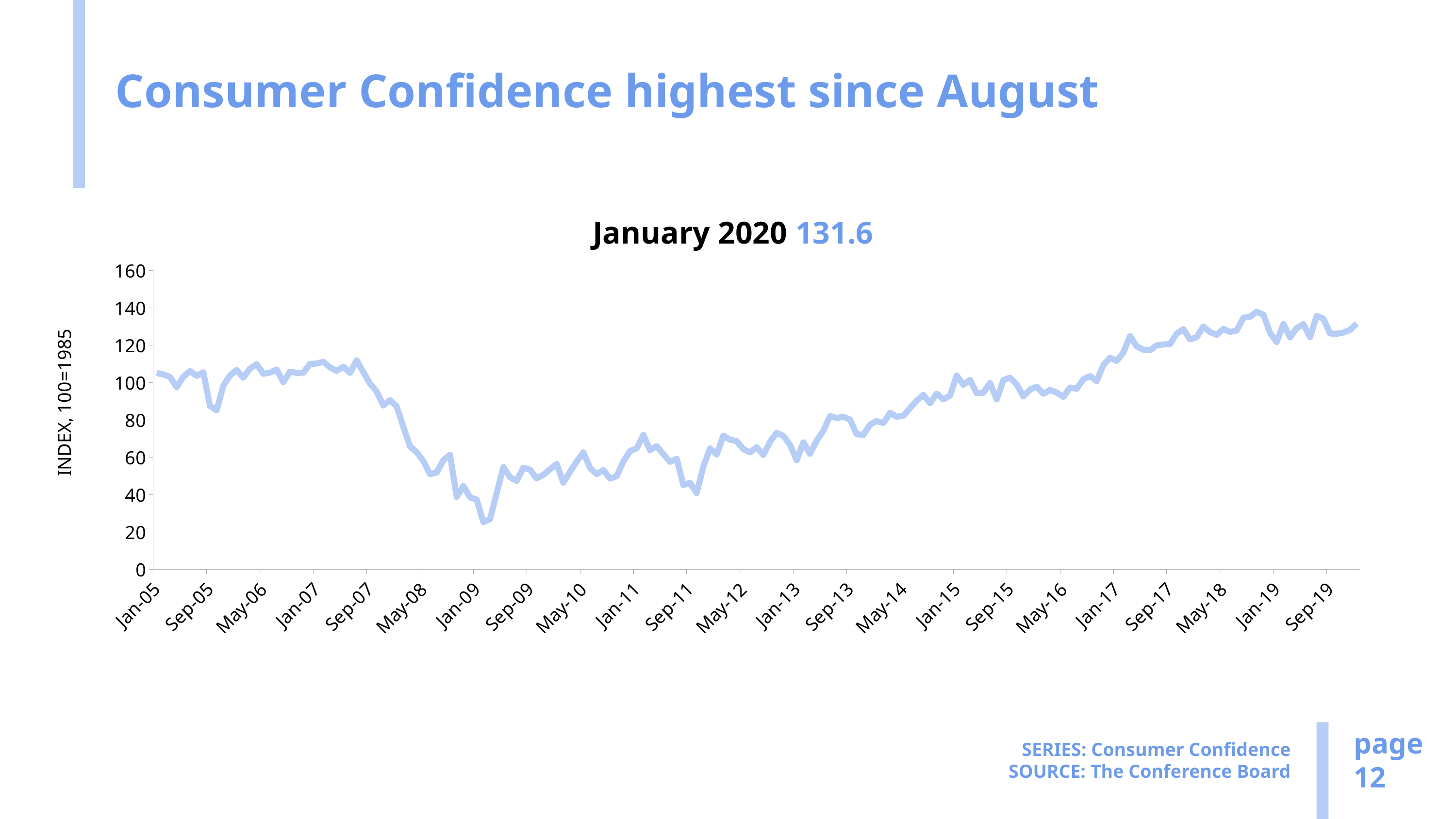
What kind of chart is shown on the slide? line chart Is the value for Jan-09 greater or less than 60? less What is the label on the vertical axis? INDEX, 100=1985 Is the value for Sep-19 greater or less than 120? greater Is the value for Jan-05 greater or less than 100? greater What is the Consumer Confidence index value shown for January 2020? 131.6 In which year does the line reach its lowest point? 2009 Does the line generally rise or fall between Jan-09 and Sep-19? rise Does the line generally rise or fall between Jan-07 and Jan-09? fall Which is larger, the value for Jan-05 or the value for Jan-09? Jan-05